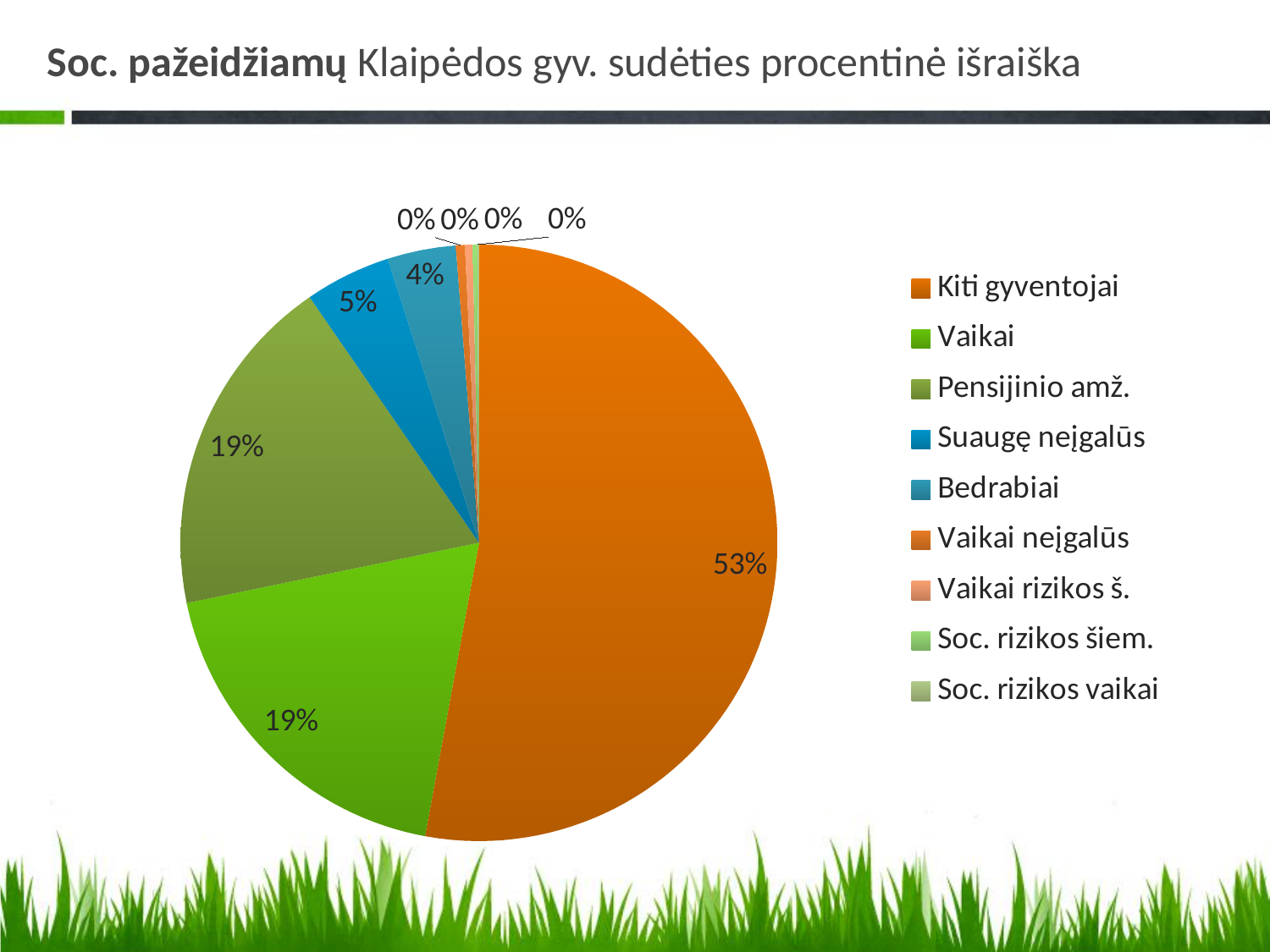
Which is larger, the slice for Suaugę neįgalūs or the slice for Bedrabiai? Suaugę neįgalūs Which category has the largest slice of the pie? Kiti gyventojai What share of the pie does Bedrabiai have? 4% What share of the pie does Vaikai neįgalūs have? 0% What is the difference in percentage points between the Kiti gyventojai slice and the Vaikai slice? 34 percentage points What share of the pie does Kiti gyventojai have? 53% What type of chart is shown on the slide? pie chart What is the title of the slide containing the chart? Soc. pažeidžiamų Klaipėdos gyv. sudėties procentinė išraiška How many categories does the legend list? 9